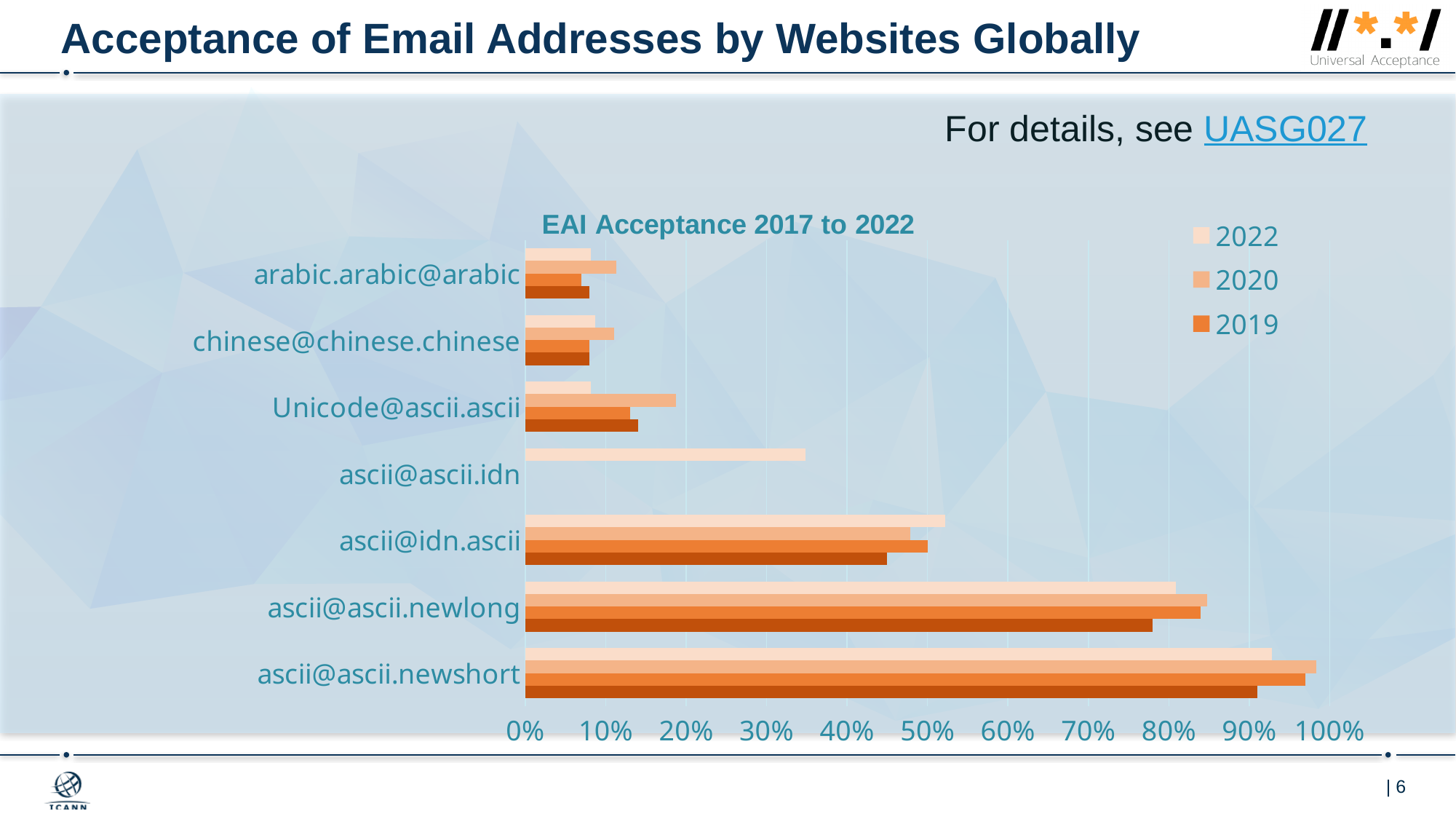
Which category has the highest value for the 2022 series? ascii@ascii.newshort Which years are listed in the chart's legend? 2022, 2020, 2019 Which has the larger 2022 value, ascii@idn.ascii or ascii@ascii.idn? ascii@idn.ascii What kind of chart is shown on the slide? bar chart Is the 2020 value for Unicode@ascii.ascii greater or less than 10%? greater How many email address categories are plotted on the chart? 7 Is the 2022 value for ascii@ascii.idn greater or less than 30%? greater How many series does the legend of the chart list? 3 What is the title of the chart? EAI Acceptance 2017 to 2022 Is the 2022 value for ascii@ascii.newshort greater or less than 90%? greater